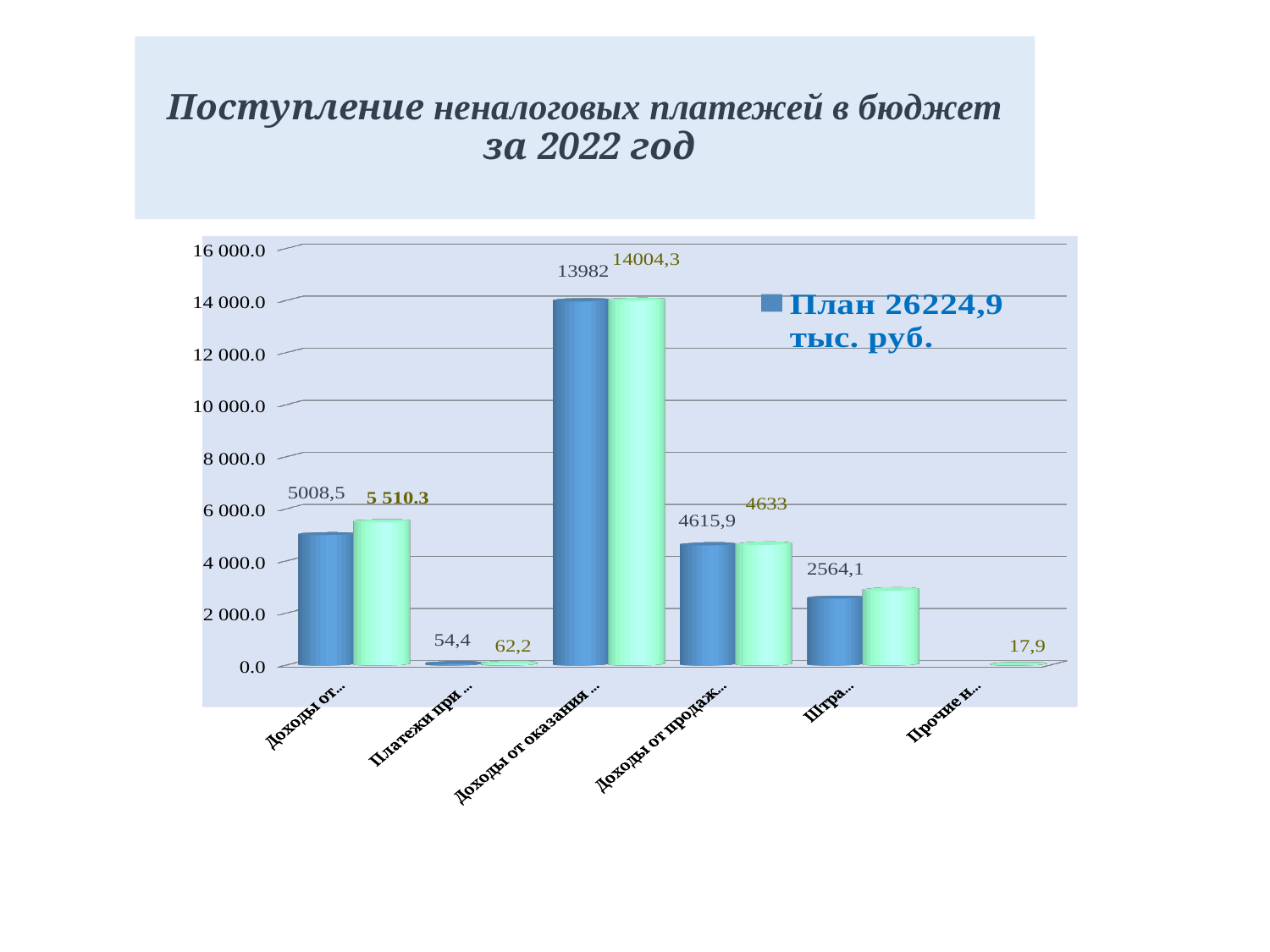
What is the value of the green bar for the third category, "Доходы от оказания ..."? 14004,3 What kind of chart is shown on the slide? bar chart For the first category, "Доходы от...", which is larger: the blue (План) bar or the green bar? the green bar How many categories are shown along the x axis of the chart? 6 Which category has the highest bars in the chart? Доходы от оказания ... What is the value of the green bar for the last category, "Прочие н..."? 17,9 How many series does the chart's legend list? 1 What is the value of the blue (План) bar for the fifth category, "Штра..."? 2564,1 Is the value of the green bar for the fifth category, "Штра...", greater or less than 2 000.0? greater What is the difference between the green bar (14004,3) and the blue bar (13982) for the third category, "Доходы от оказания ..."? 22,3 What is the legend entry shown on the chart? План 26224,9 тыс. руб. What is the value of the blue (План) bar for the first category, "Доходы от..."? 5008,5